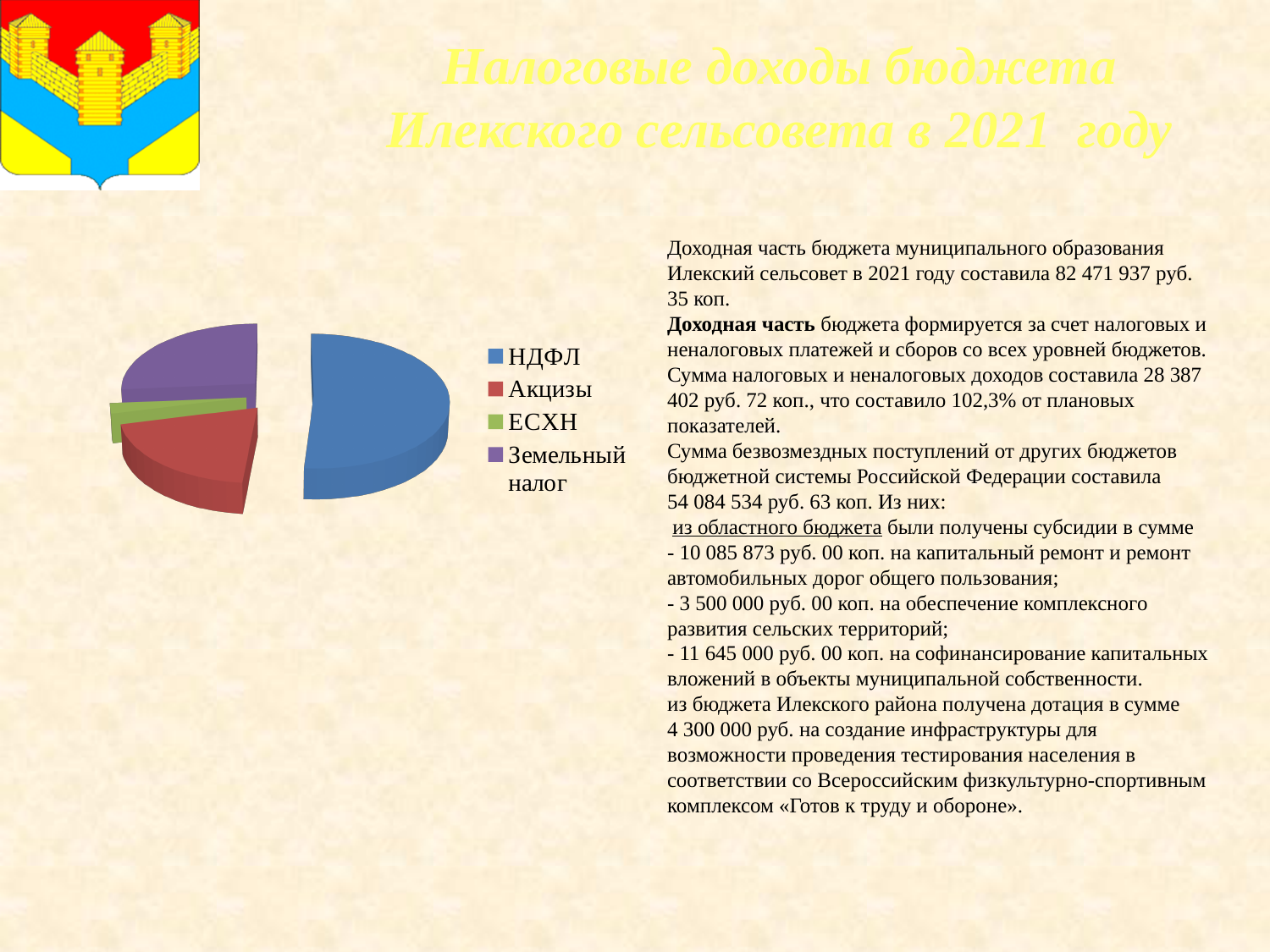
How many entries does the legend of the pie chart list? 4 Which slice is larger in the pie chart, НДФЛ or ЕСХН? НДФЛ Which slice is larger in the pie chart, Акцизы or ЕСХН? Акцизы Which slice is larger in the pie chart, Земельный налог or ЕСХН? Земельный налог Which category has the smallest slice in the pie chart? ЕСХН What kind of chart is shown on the slide? pie chart Which category in the pie chart legend is shown in green? ЕСХН Which category has the largest slice in the pie chart? НДФЛ What colour is the НДФЛ slice in the pie chart? blue How many categories does the pie chart show? 4